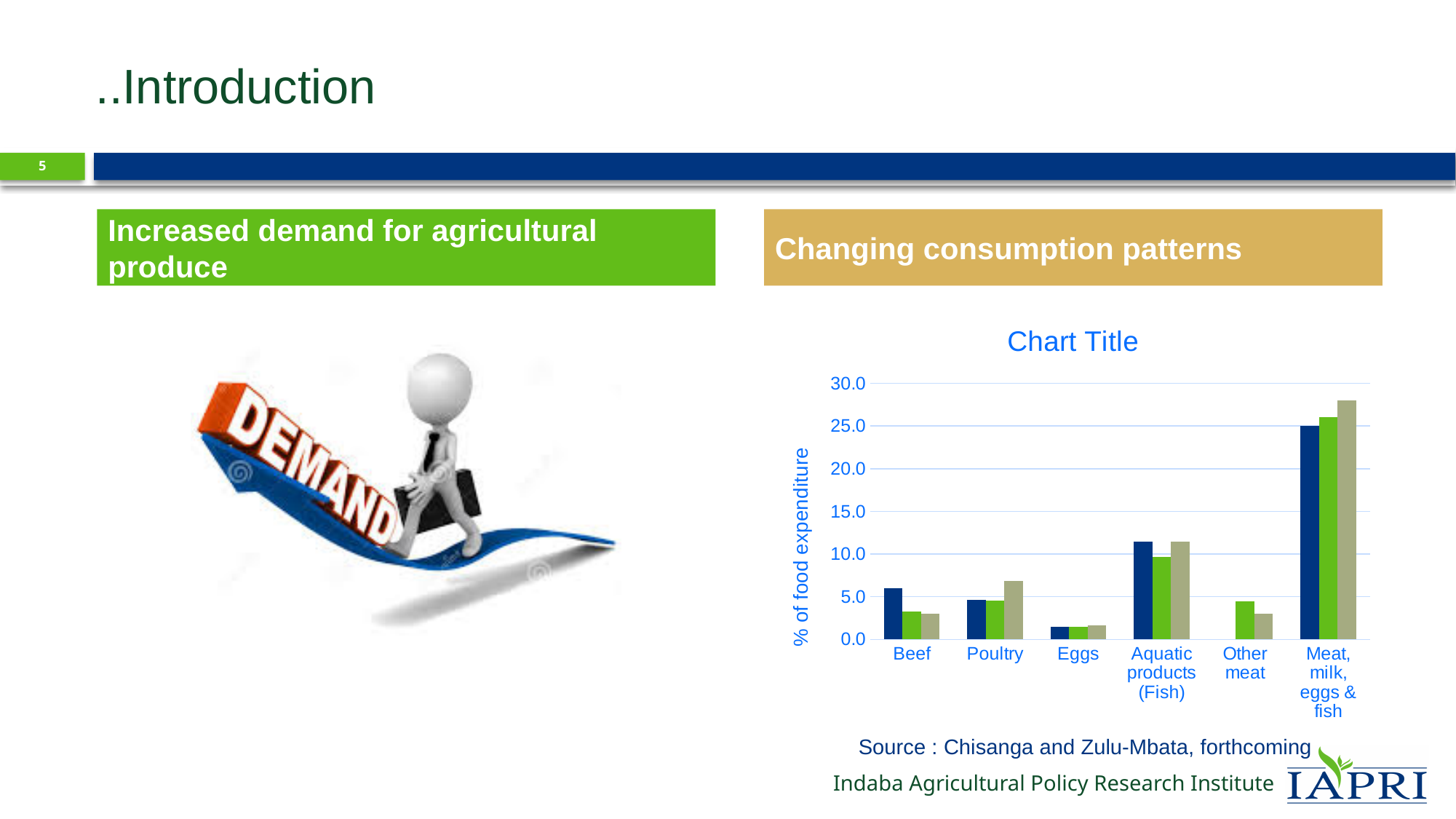
What is the title shown above the chart? Chart Title Are the values for Aquatic products (Fish) greater or less than 5.0? greater Which category has larger values, Aquatic products (Fish) or Poultry? Aquatic products (Fish) Is the tan bar for Poultry greater or less than 5.0? greater What is the label on the y axis of the chart? % of food expenditure How many categories are shown on the x axis of the chart? 6 Which category has the highest bars in the chart? Meat, milk, eggs & fish Are the values for Eggs greater or less than 5.0? less What kind of chart is shown on the slide? bar chart Which category has larger values, Meat, milk, eggs & fish or Beef? Meat, milk, eggs & fish